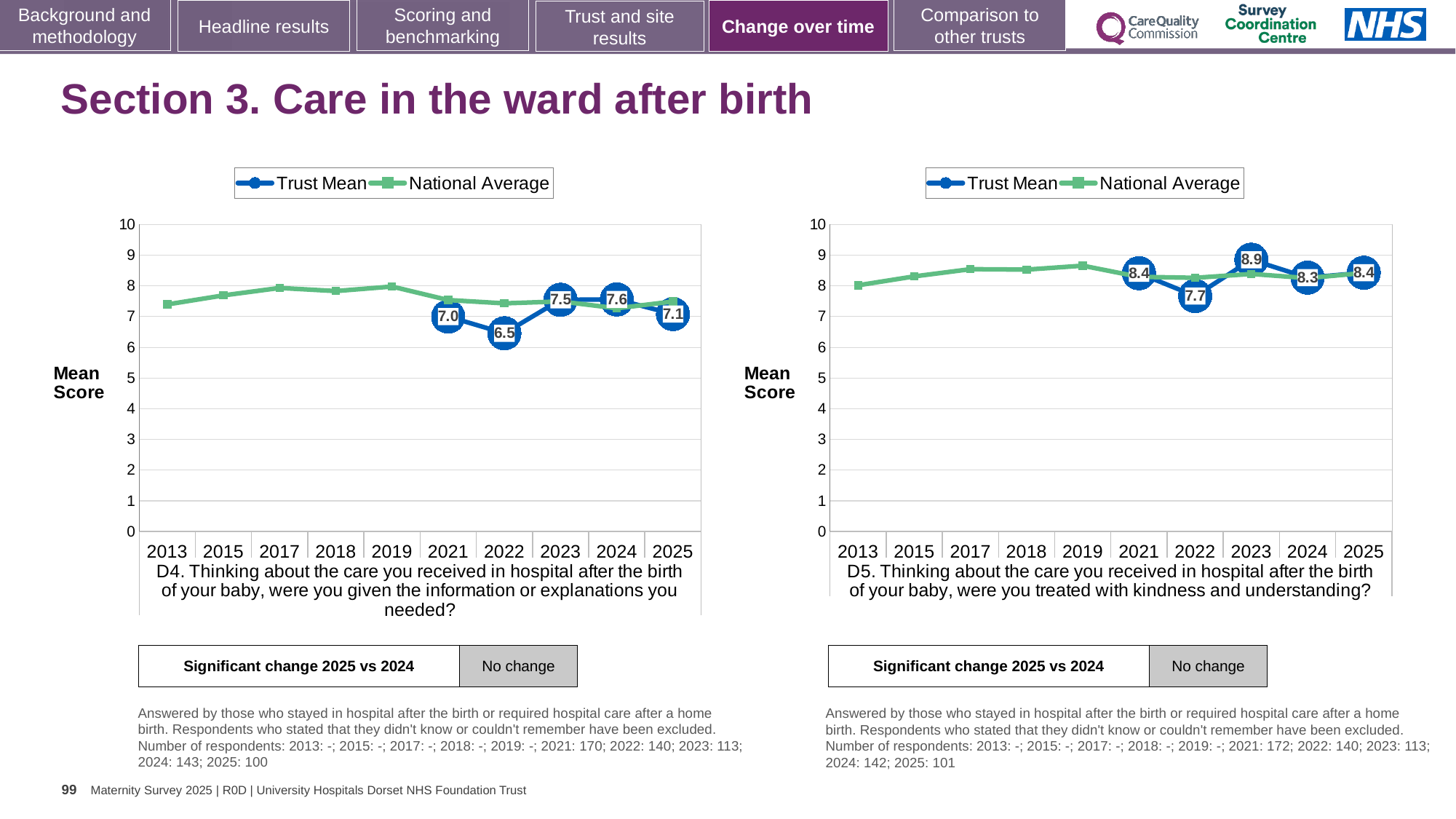
In the right chart (D5), what is the Trust Mean score for 2023? 8.9 What kind of chart is the left chart (D4)? Line chart In the right chart (D5), which year has the lowest labelled Trust Mean score? 2022 How many series does the legend of the right chart (D5) list? 2 In the right chart (D5), what is the difference between the Trust Mean scores for 2025 and 2024? 0.1 How many years are shown on the x axis of the left chart (D4)? 10 In the left chart (D4), what is the Trust Mean score for 2022? 6.5 In the left chart (D4), is the National Average value for 2013 greater or less than 8? less In the right chart (D5), is the Trust Mean score for 2023 larger than the Trust Mean score for 2022? Yes In the left chart (D4), what is the difference between the Trust Mean scores for 2024 and 2022? 1.1 In the left chart (D4), which year has the highest labelled Trust Mean score? 2024 In the right chart (D5), is the National Average value for 2019 greater or less than 8? greater